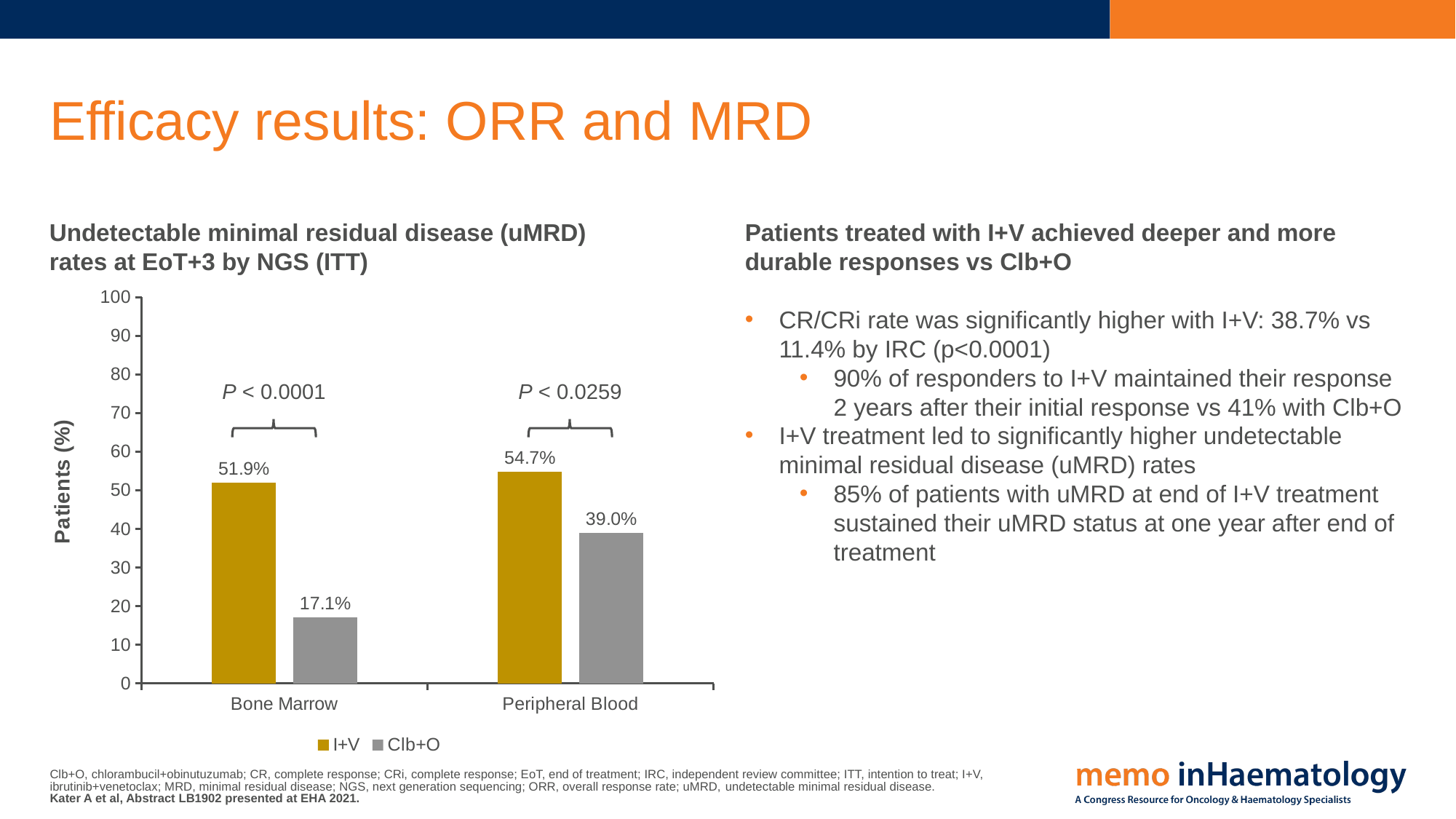
How many categories are shown on the x axis? 2 What is the uMRD rate for I+V in Bone Marrow? 51.9% Which bar has the lowest value on the chart? Clb+O, Bone Marrow What is the difference between the I+V and Clb+O uMRD rates in Peripheral Blood? 15.7% What is the label of the y axis? Patients (%) What is the uMRD rate for Clb+O in Bone Marrow? 17.1% Which is larger: the I+V rate in Bone Marrow or the Clb+O rate in Peripheral Blood? I+V rate in Bone Marrow What kind of chart is shown on the slide? Bar chart What is the uMRD rate for Clb+O in Peripheral Blood? 39.0% Which bar has the highest value on the chart? I+V, Peripheral Blood How many series does the legend list? 2 What is the difference between the I+V and Clb+O uMRD rates in Bone Marrow? 34.8%